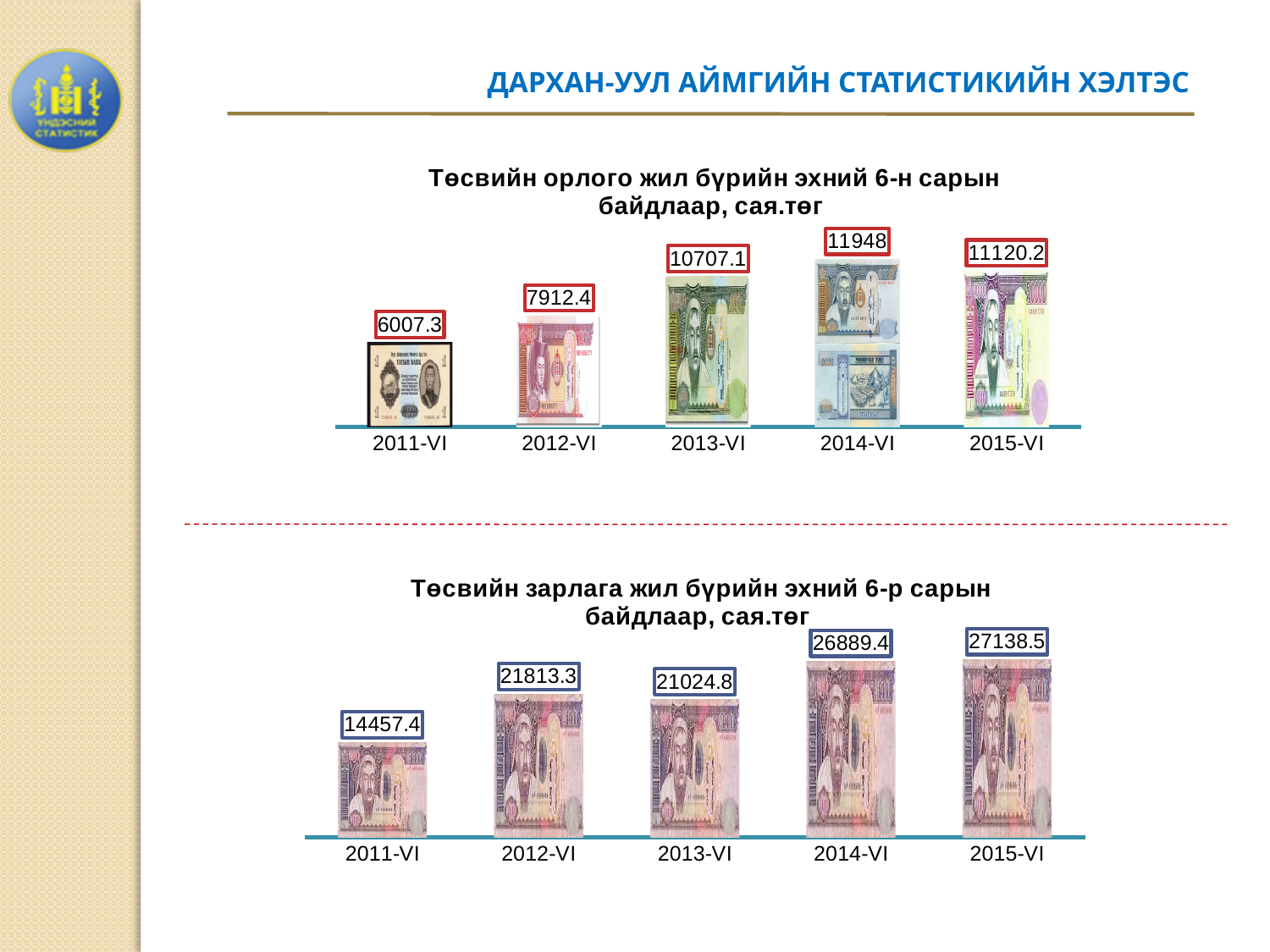
In the bottom chart (Төсвийн зарлага), which year has the lowest value? 2011-VI In the top chart (Төсвийн орлого), how many years are shown on the x axis? 5 In the bottom chart (Төсвийн зарлага), what is the value for 2015-VI? 27138.5 In the top chart (Төсвийн орлого), do the values rise or fall from 2011-VI to 2014-VI? Rise In the top chart (Төсвийн орлого), what is the value for 2013-VI? 10707.1 What kind of chart is the top chart (Төсвийн орлого)? Bar chart In the bottom chart (Төсвийн зарлага), which is larger, the value for 2012-VI or 2013-VI? 2012-VI In the top chart (Төсвийн орлого), what is the difference between the values for 2014-VI and 2013-VI? 1240.9 In the top chart (Төсвийн орлого), which year has the lowest value? 2011-VI In the bottom chart (Төсвийн зарлага), what is the difference between the values for 2015-VI and 2011-VI? 12681.1 In the top chart (Төсвийн орлого), which year has the highest value? 2014-VI In the bottom chart (Төсвийн зарлага), what is the value for 2011-VI? 14457.4